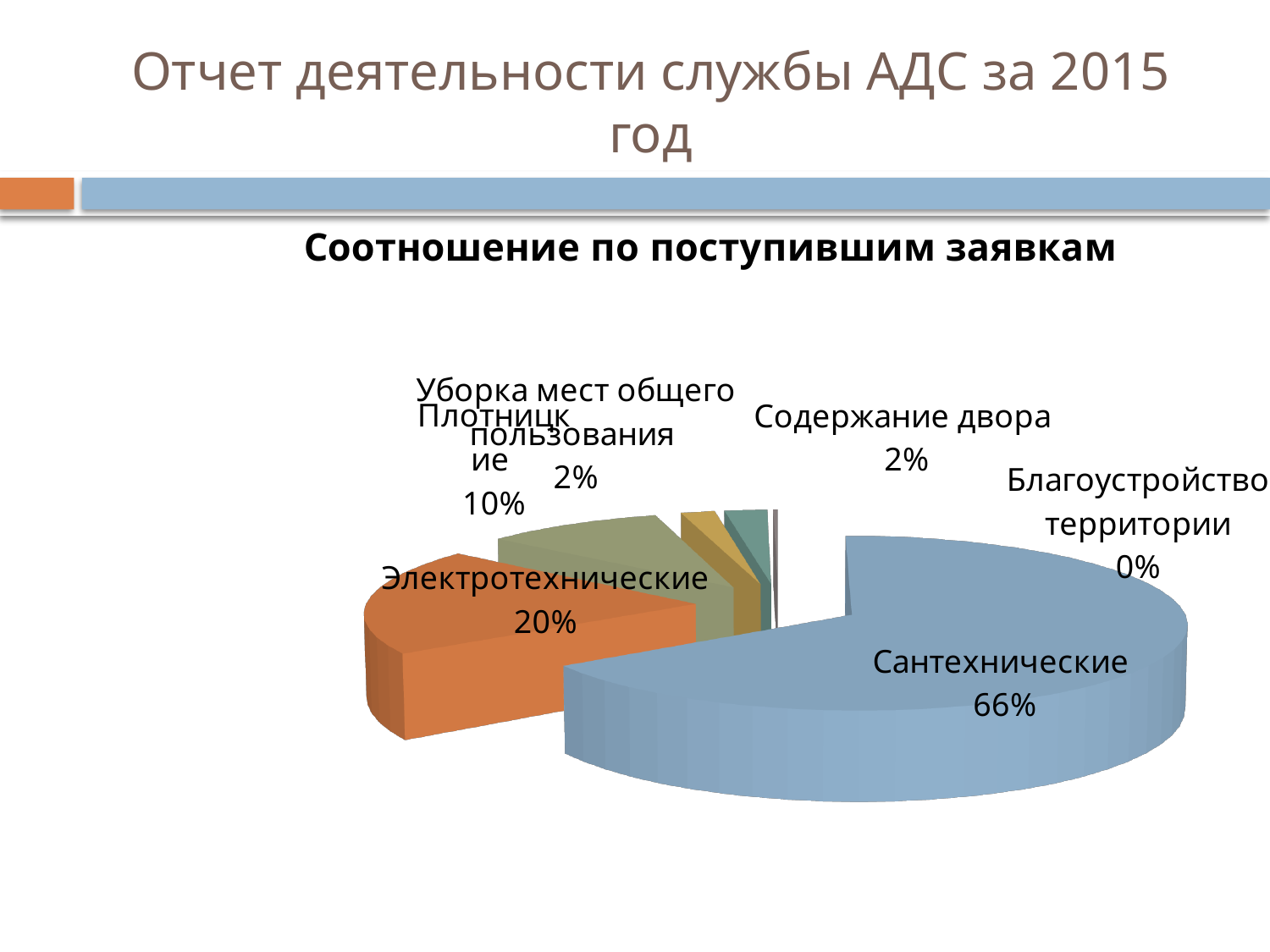
What is the title of the chart? Соотношение по поступившим заявкам What share of the pie does Благоустройство территории have? 0% How many categories are shown in the pie chart? 6 What share of the pie does Сантехнические have? 66% What share of the pie does Содержание двора have? 2% Which is larger, the share of Электротехнические or the share of Плотницкие? Электротехнические Which category has the smallest share of the pie? Благоустройство территории What is the difference between the shares of Сантехнические and Электротехнические? 46% Which category has the largest share of the pie? Сантехнические What kind of chart is shown on the slide? Pie chart